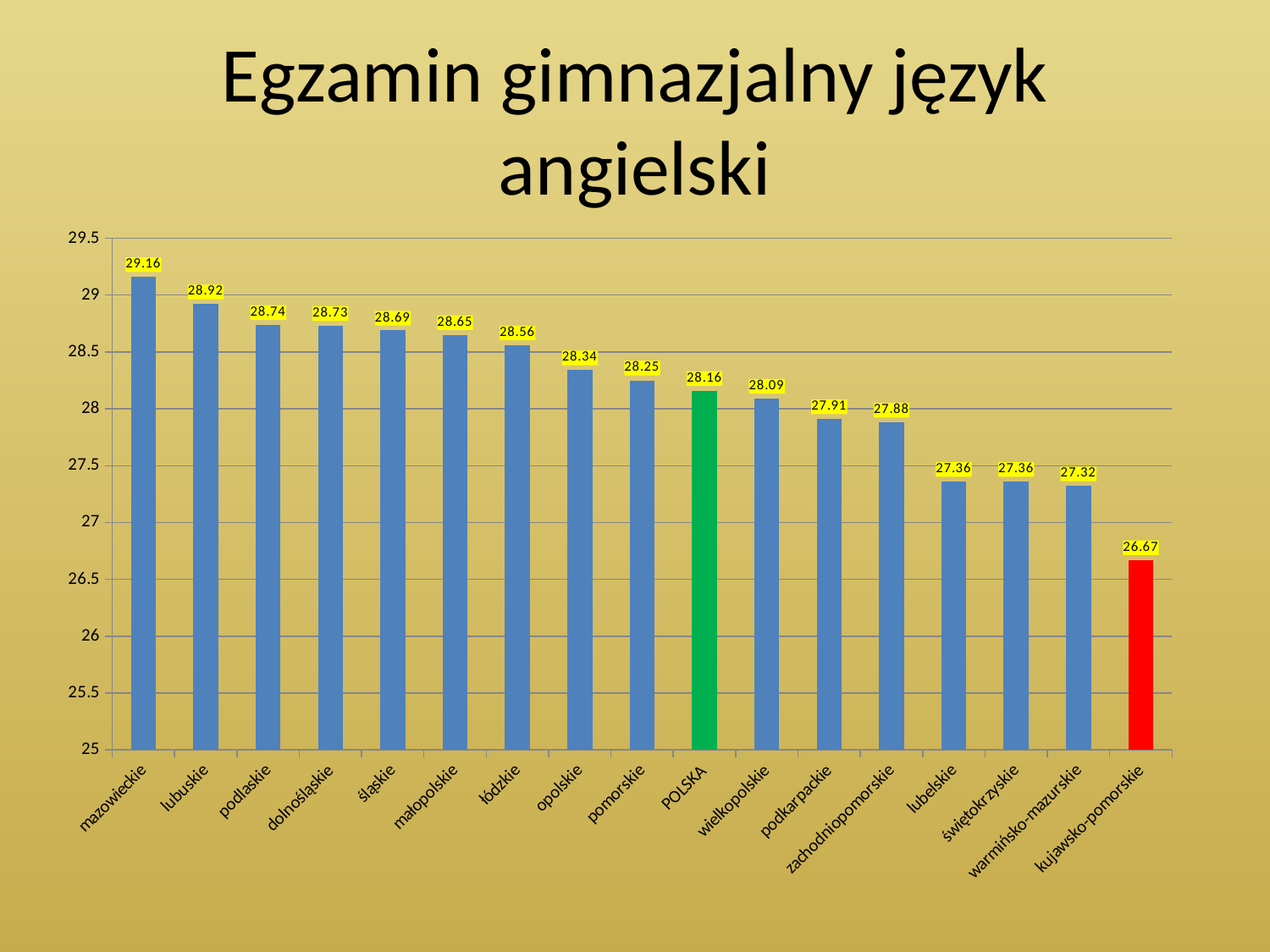
What is the value for POLSKA? 28.16 Which category has the lowest value? kujawsko-pomorskie How many categories are shown on the x axis? 17 What kind of chart is shown on the slide? bar chart What is the value for mazowieckie? 29.16 What is the difference between the values for POLSKA and wielkopolskie? 0.07 Which category has the highest value? mazowieckie Do the values rise or fall from left to right along the x axis? fall Which is larger, the value for lubuskie or the value for opolskie? lubuskie Is the value for lubelskie greater or less than 27.5? less What is the value for kujawsko-pomorskie? 26.67 What is the difference between the values for mazowieckie and kujawsko-pomorskie? 2.49